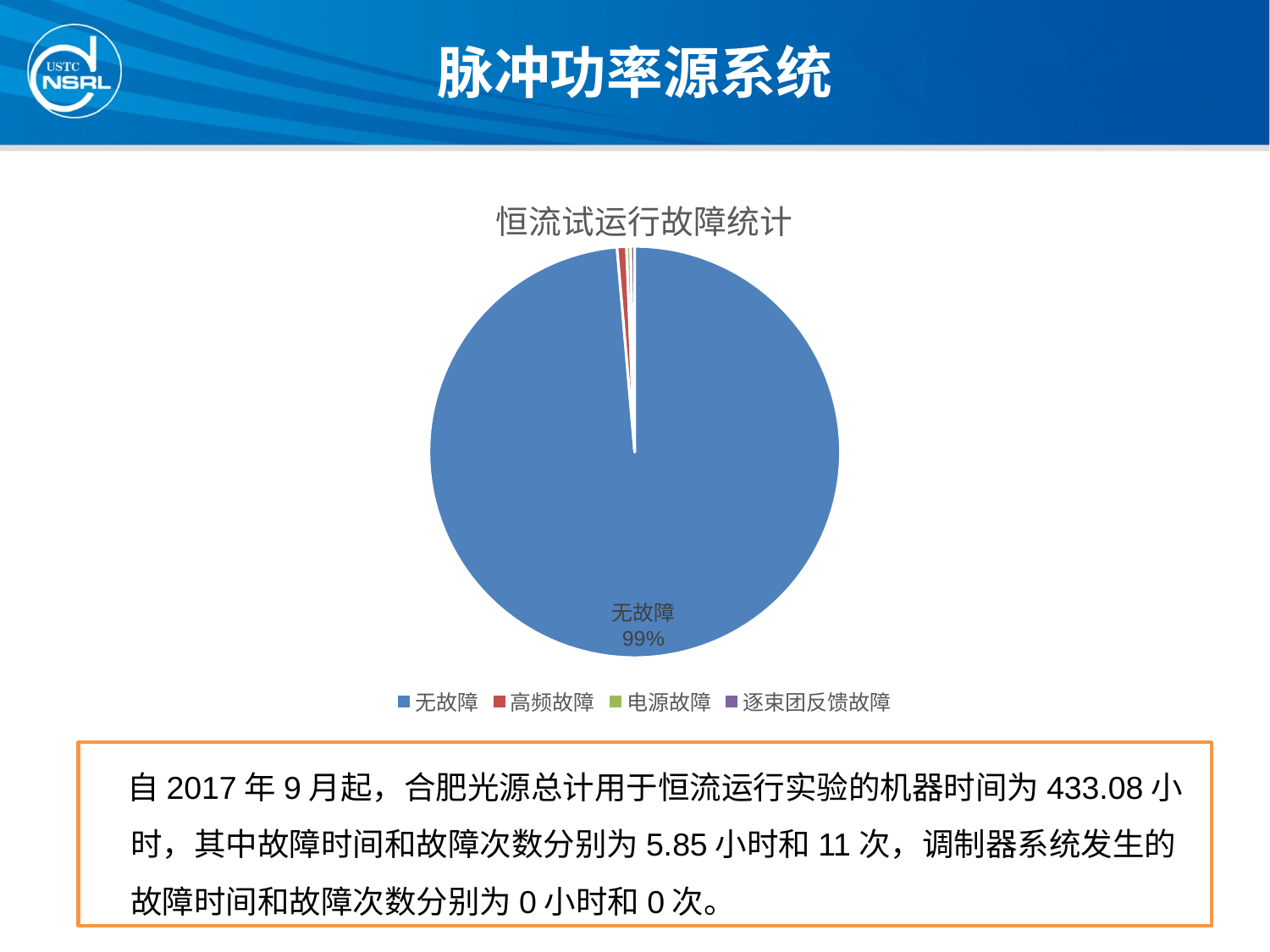
Which slice has a percentage label printed on the chart? 无故障 How many categories are shown in the pie chart? 4 What is the title of the chart? 恒流试运行故障统计 Which category has the largest slice of the pie? 无故障 Which category is shown in red in the legend? 高频故障 What kind of chart is shown on the slide? pie chart What share of the pie does 无故障 take? 99% Which is larger, the slice for 无故障 or the slice for 高频故障? 无故障 How many entries does the chart's legend list? 4